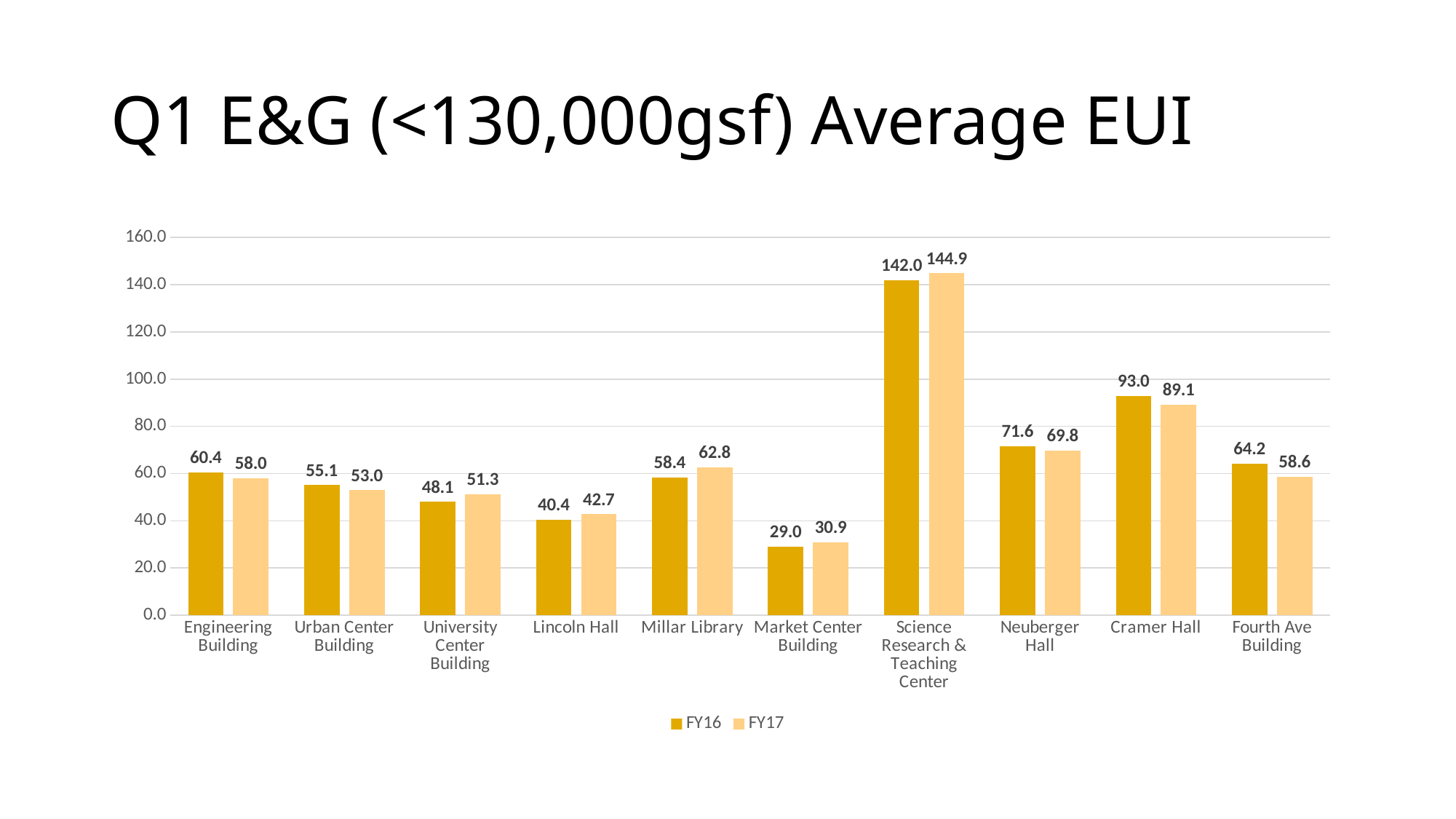
What is the FY16 value for Cramer Hall? 93.0 How many series does the legend list? 2 What is the FY17 value for Lincoln Hall? 42.7 What is the difference between the FY17 and FY16 values for Millar Library? 4.4 What is the FY17 value for Market Center Building? 30.9 Which building has the lowest FY16 value? Market Center Building What kind of chart is shown on the slide? bar chart Which is larger for Engineering Building, the FY16 value or the FY17 value? FY16 Which building has the highest FY17 value? Science Research & Teaching Center Is the FY16 value for Science Research & Teaching Center greater or less than 120.0? greater How many buildings are shown on the x axis? 10 What is the difference between the FY16 values for Cramer Hall and Neuberger Hall? 21.4